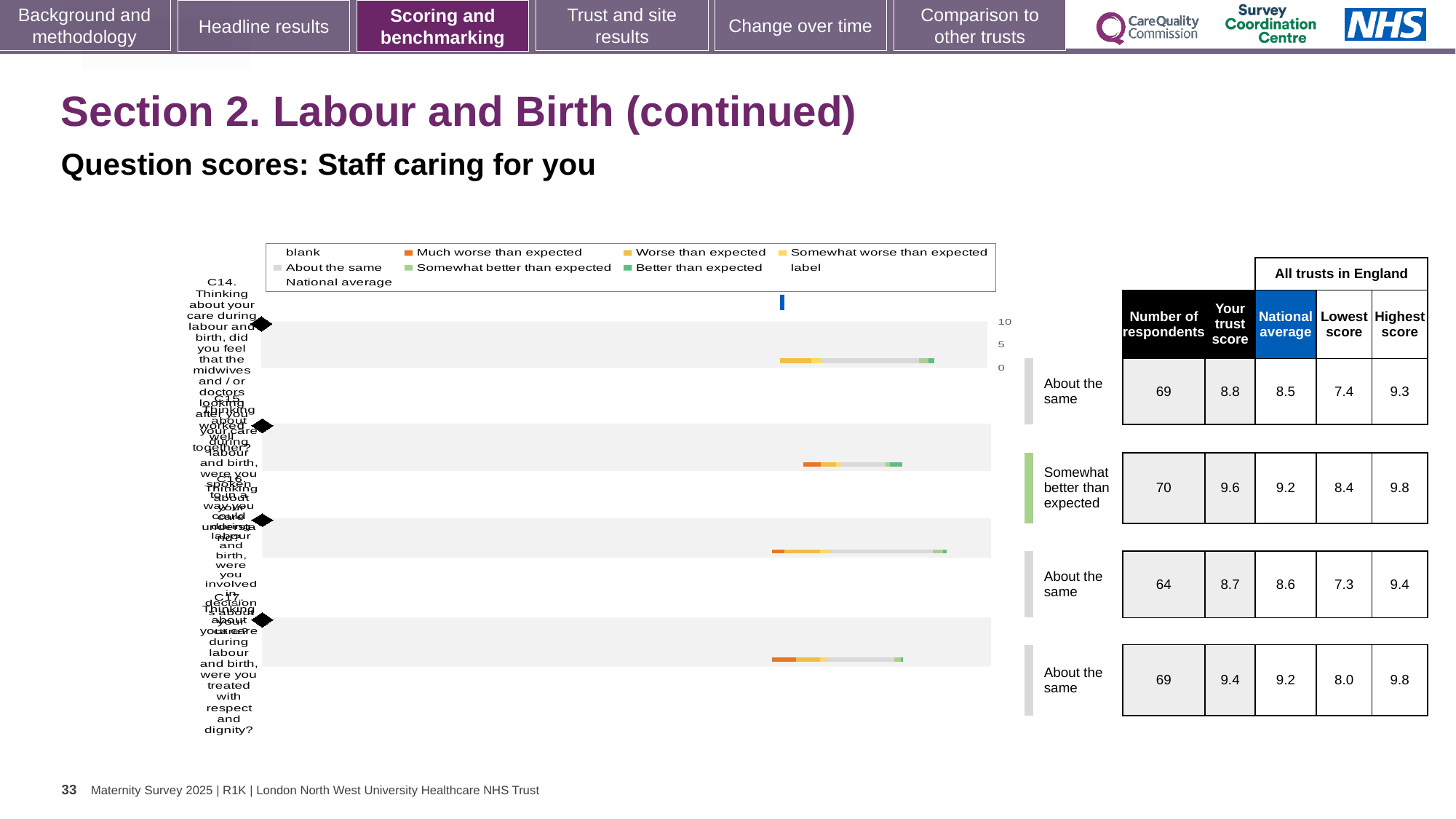
What kind of chart is shown on the slide? bar chart In the table beside the chart, which row has the highest trust score? the second row (Somewhat better than expected), 9.6 Which legend entry is shown in green as the best benchmark category? Better than expected In the table beside the chart, what is the difference between the highest trust score (9.6) and the lowest trust score (8.7)? 0.9 In the table beside the chart, what is the national average for the first row? 8.5 In the table beside the chart, which row has the lowest trust score? the third row, 8.7 In the table beside the chart, what is the trust score for the second row (Somewhat better than expected)? 9.6 What is the subtitle above the chart? Question scores: Staff caring for you How many entries does the chart legend list? 9 In the table beside the chart, how many respondents are listed for the third row? 64 How many question rows (bars) does the chart show? 4 In the table beside the chart, is the trust score for the fourth row (9.4) larger or smaller than its national average (9.2)? larger